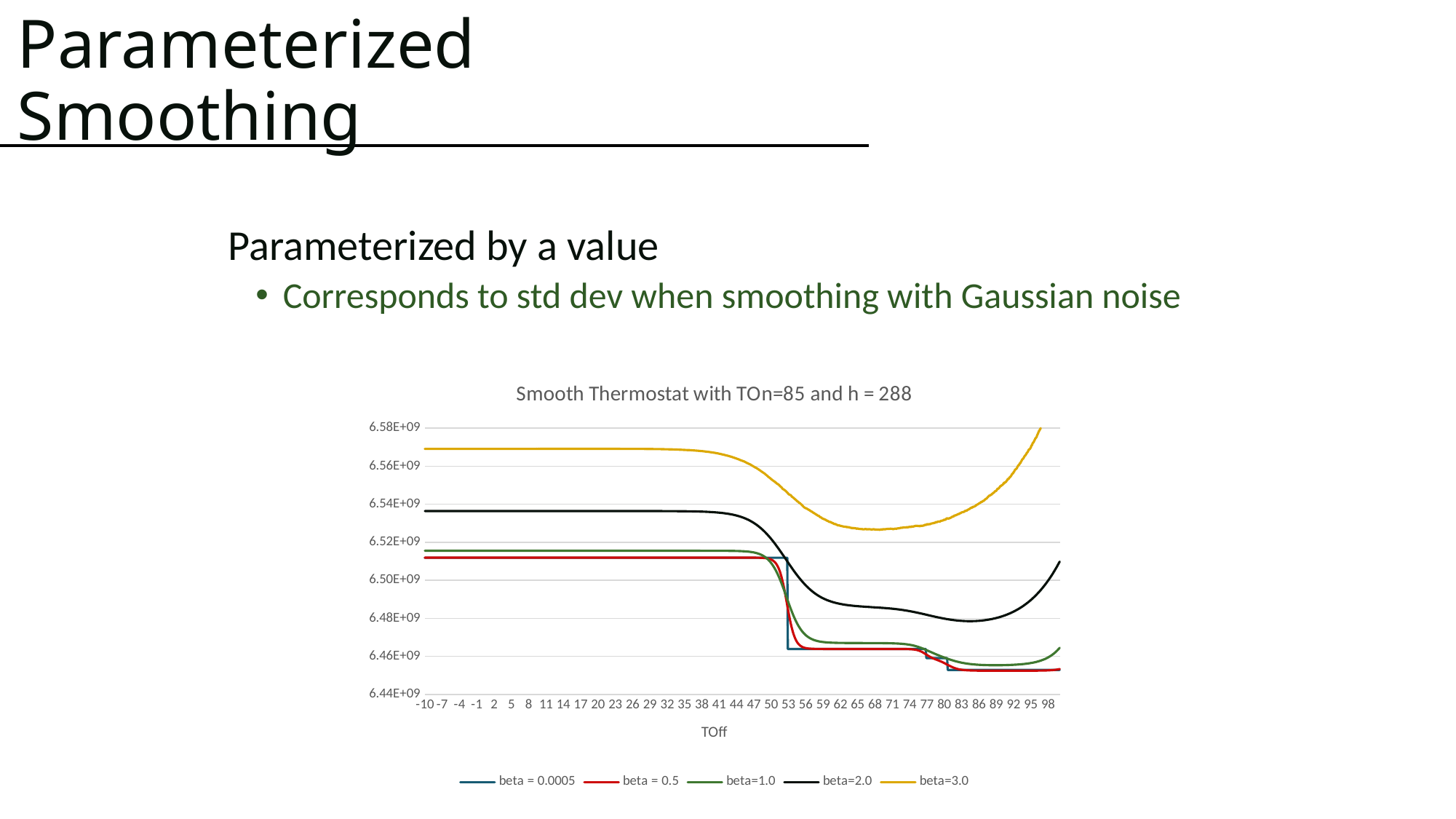
Is the value of the beta=2.0 series at TOff = 20 greater or less than 6.52E+09? greater Is the value of the beta=3.0 series at TOff = 20 greater or less than 6.56E+09? greater How many series does the chart legend list? 5 What kind of chart is shown on the slide? line chart At TOff = 98, which is larger: the beta=2.0 series or the beta=1.0 series? beta=2.0 Is the value of the beta=3.0 series at TOff = 68 greater or less than 6.54E+09? less Does the beta=3.0 series rise or fall between TOff = 44 and TOff = 68? fall Which series has the highest value at TOff = 20? beta=3.0 How many tick labels are shown on the x axis? 37 What is the label of the x axis? TOff What is the title of the chart? Smooth Thermostat with TOn=85 and h = 288